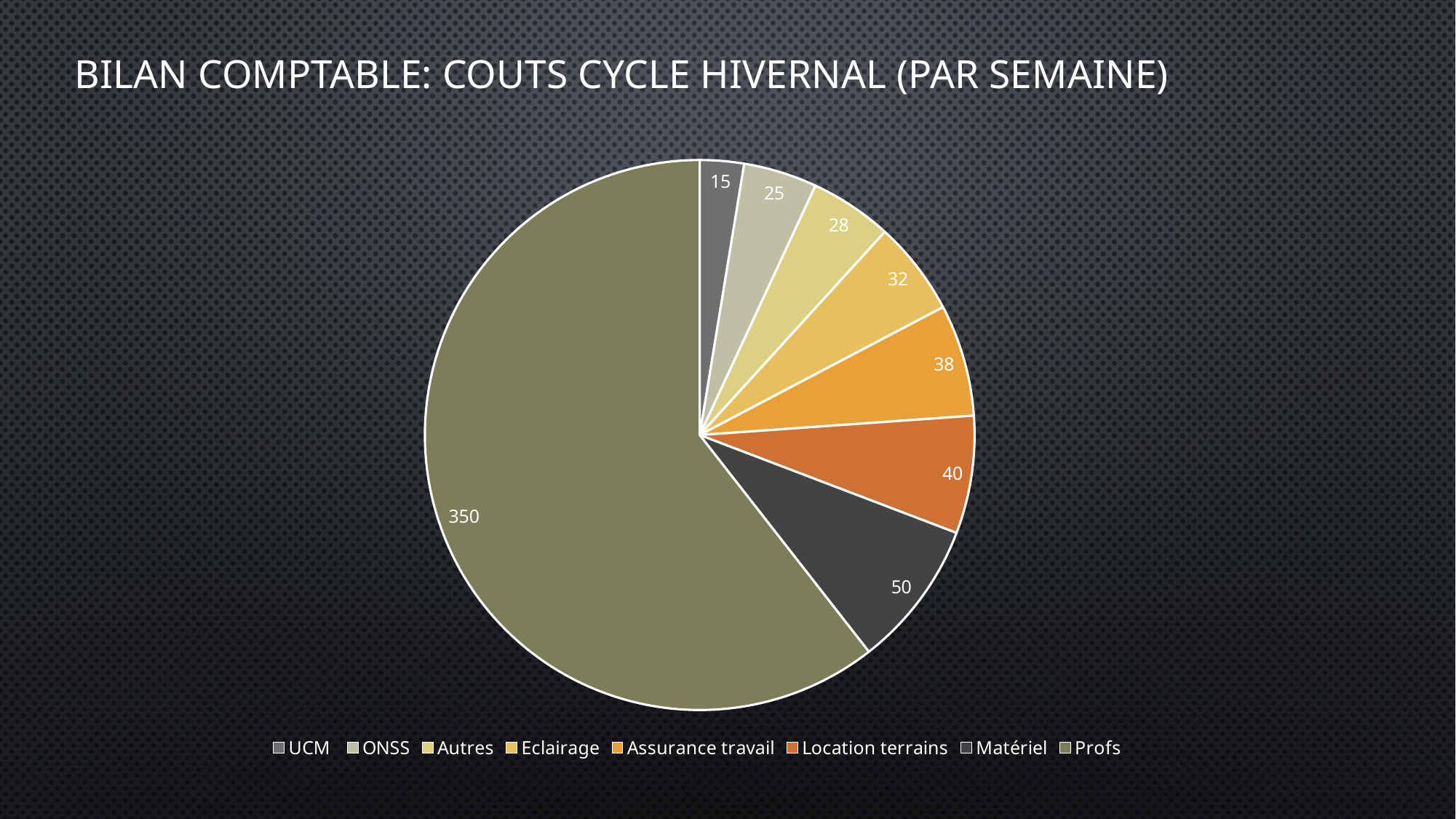
What is the value for Assurance travail? 38 What is the value for Profs? 350 What is the value for UCM? 15 Which category has the smallest slice? UCM How many categories does the pie chart have? 8 What is the title of the chart on the slide? BILAN COMPTABLE: COUTS CYCLE HIVERNAL (PAR SEMAINE) What type of chart is shown on the slide? Pie chart Which category has the largest slice? Profs Which is larger, the value for Autres or the value for Matériel? Matériel What is the difference between the values for Location terrains and ONSS? 15 What is the value for Matériel? 50 What is the value for Eclairage? 32